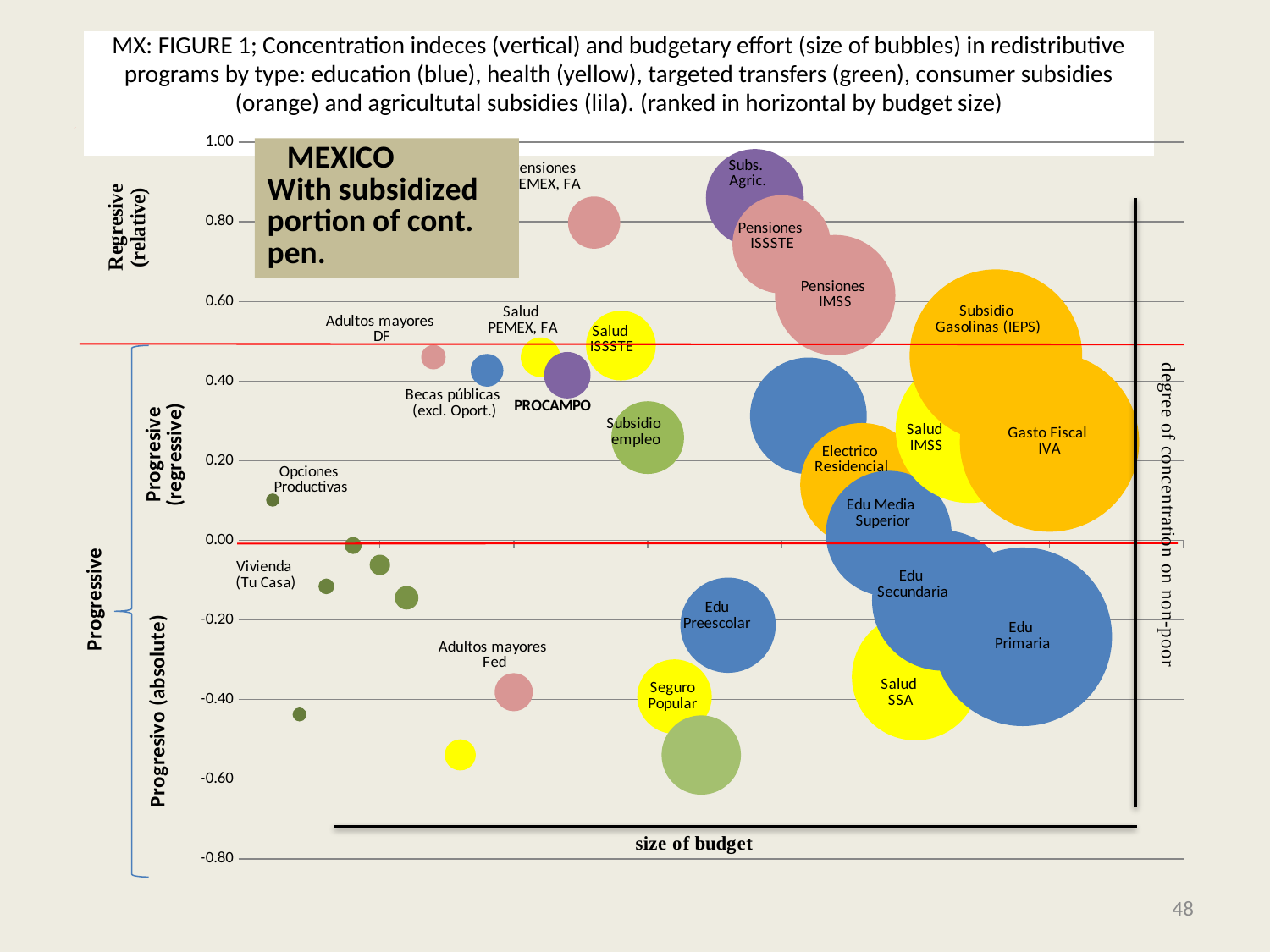
According to the chart title, which colour represents education programs? blue Is the concentration index for Salud SSA greater or less than -0.20? less Which labelled program has the highest concentration index on the chart? Subs. Agric. Is the concentration index for Subsidio empleo greater or less than 0.40? less What kind of chart is shown on the slide? bubble chart Is the concentration index for Edu Primaria greater or less than 0.00? less Which has a higher concentration index, Subs. Agric. or Seguro Popular? Subs. Agric.